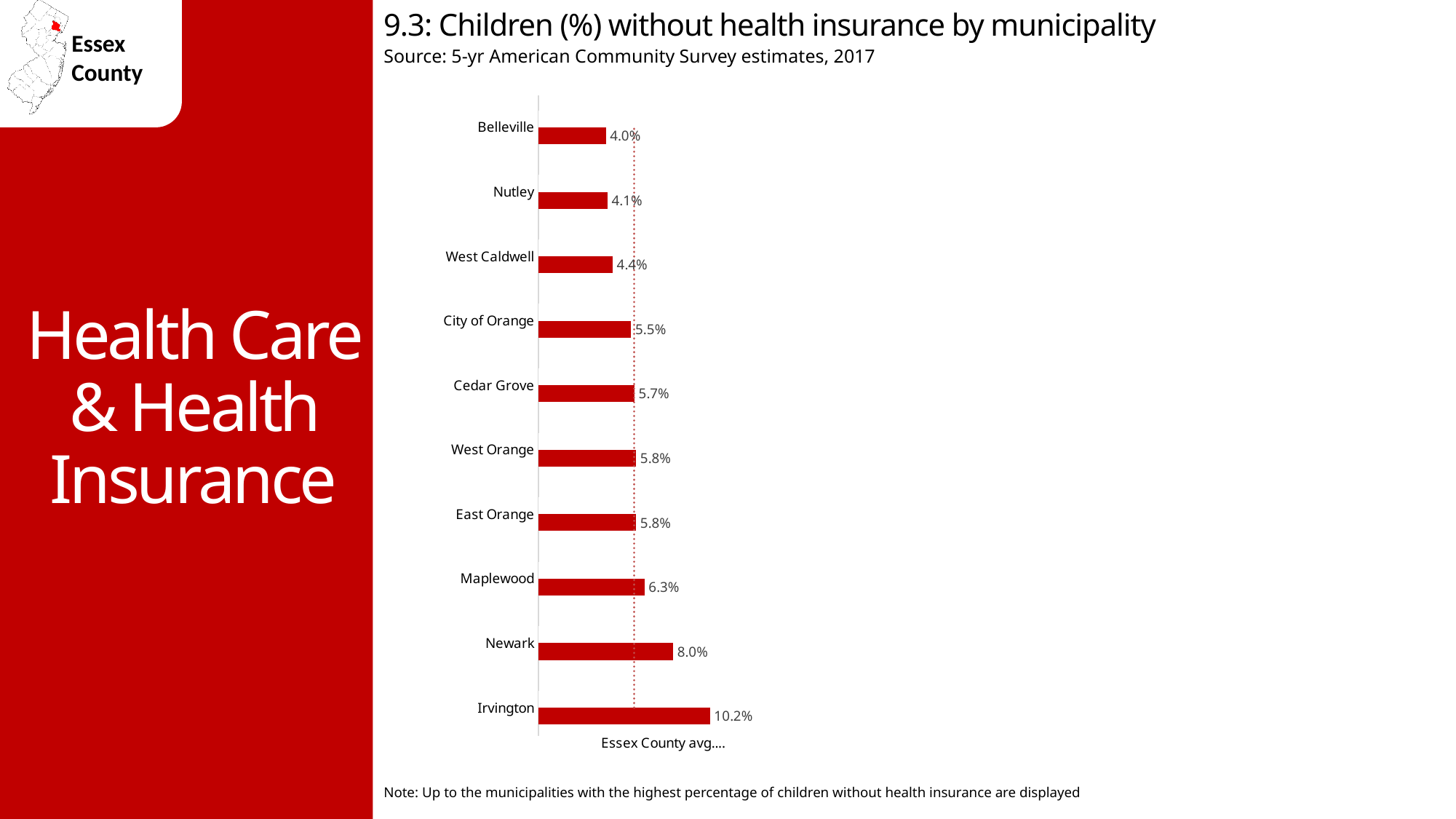
What is the value shown for Maplewood? 6.3% Which municipality has the highest percentage of children without health insurance? Irvington What type of chart is used on this slide? Bar chart What is the difference between the values for Maplewood and Belleville? 2.3% What is the title of the chart? 9.3: Children (%) without health insurance by municipality Which municipality has the lowest percentage of children without health insurance? Belleville What percentage of children in Newark are without health insurance? 8.0% How many municipalities are shown in the chart? 10 What does the dotted vertical line in the chart represent? Essex County avg. What percentage is shown for West Caldwell? 4.4% Which has a higher percentage of children without health insurance, Cedar Grove or Nutley? Cedar Grove What is the difference between the values for Irvington and Newark? 2.2%